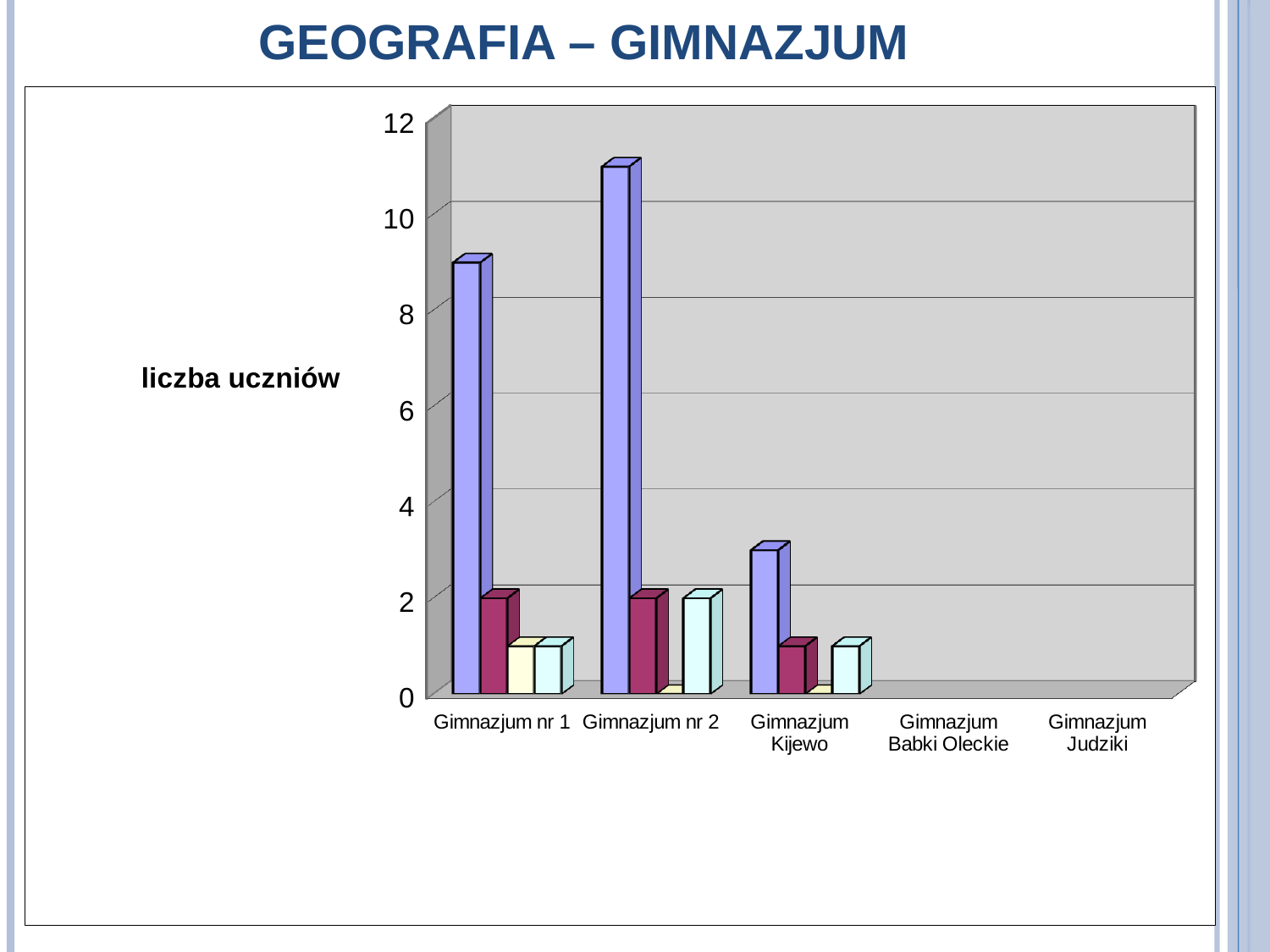
Is the tallest (blue) bar for Gimnazjum nr 2 greater or less than 10? greater How many categories are shown on the x axis of the chart? 5 What is the title of the vertical axis of the chart? liczba uczniów Is the tallest (blue) bar for Gimnazjum nr 1 greater or less than 8? greater Which has the taller blue bar, Gimnazjum nr 1 or Gimnazjum nr 2? Gimnazjum nr 2 What is the title of the slide? GEOGRAFIA – GIMNAZJUM Which categories have no visible bars in the chart? Gimnazjum Babki Oleckie and Gimnazjum Judziki What kind of chart is shown on the slide? bar chart From Gimnazjum nr 2 to Gimnazjum Judziki, do the tallest bars rise or fall along the x axis? fall Is the tallest (blue) bar for Gimnazjum Kijewo greater or less than 4? less Among Gimnazjum nr 1, Gimnazjum nr 2 and Gimnazjum Kijewo, which has the shortest blue bar? Gimnazjum Kijewo Which category has the tallest bar in the chart? Gimnazjum nr 2